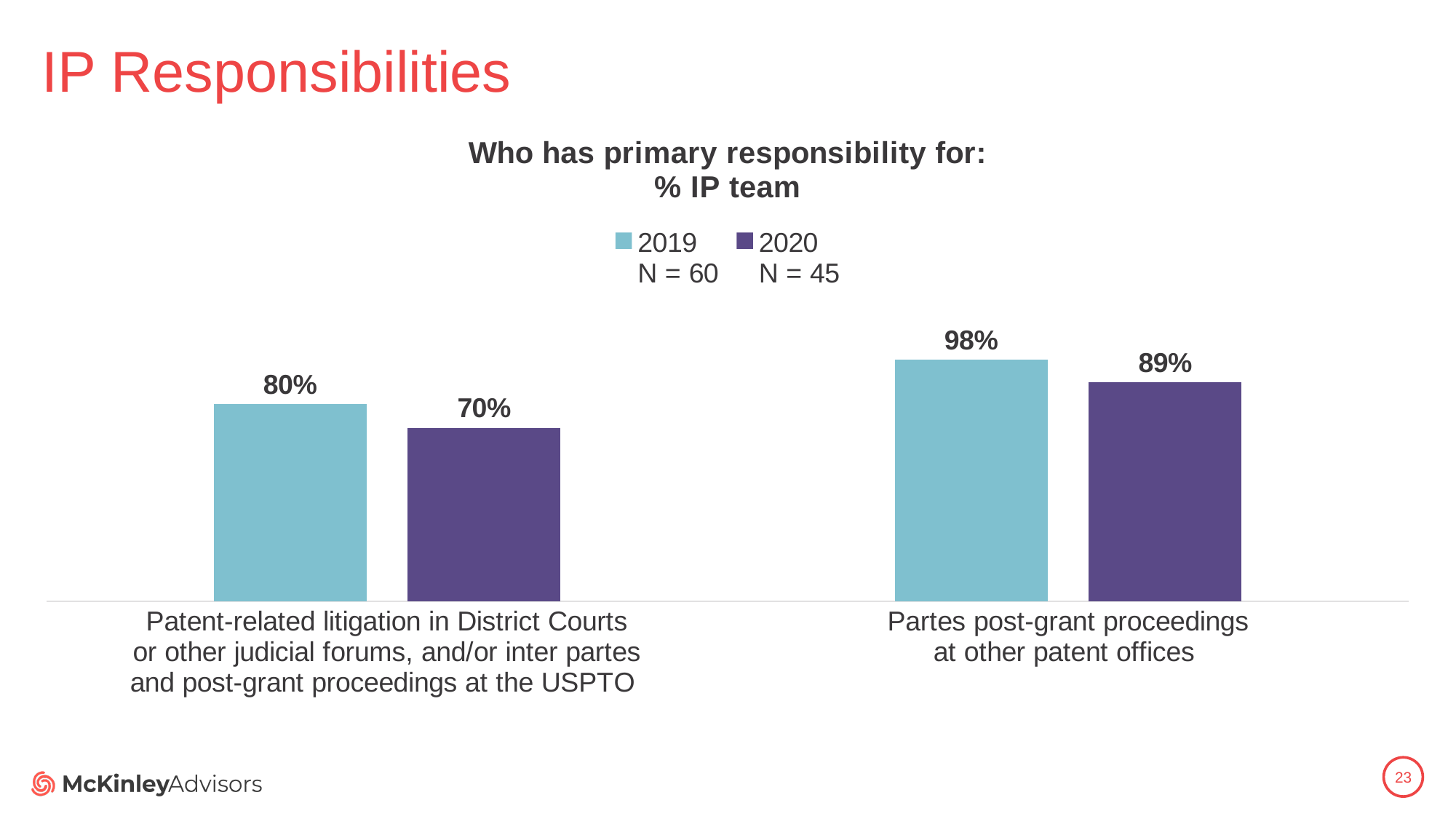
What is the 2019 value for 'Partes post-grant proceedings at other patent offices'? 98% What kind of chart is shown on the slide? Bar chart What is the 2020 value for 'Patent-related litigation in District Courts or other judicial forums, and/or inter partes and post-grant proceedings at the USPTO'? 70% Which is larger for 'Partes post-grant proceedings at other patent offices': the 2019 value or the 2020 value? 2019 What is the 2020 value for 'Partes post-grant proceedings at other patent offices'? 89% Which category has the highest 2019 value? Partes post-grant proceedings at other patent offices What is the 2019 value for 'Patent-related litigation in District Courts or other judicial forums, and/or inter partes and post-grant proceedings at the USPTO'? 80% How many series does the legend list? 2 What is the difference between the 2019 and 2020 values for 'Partes post-grant proceedings at other patent offices'? 9% How many categories are shown on the x axis? 2 Which category has the lowest 2020 value? Patent-related litigation in District Courts or other judicial forums, and/or inter partes and post-grant proceedings at the USPTO What is the difference between the 2019 and 2020 values for 'Patent-related litigation in District Courts or other judicial forums, and/or inter partes and post-grant proceedings at the USPTO'? 10%